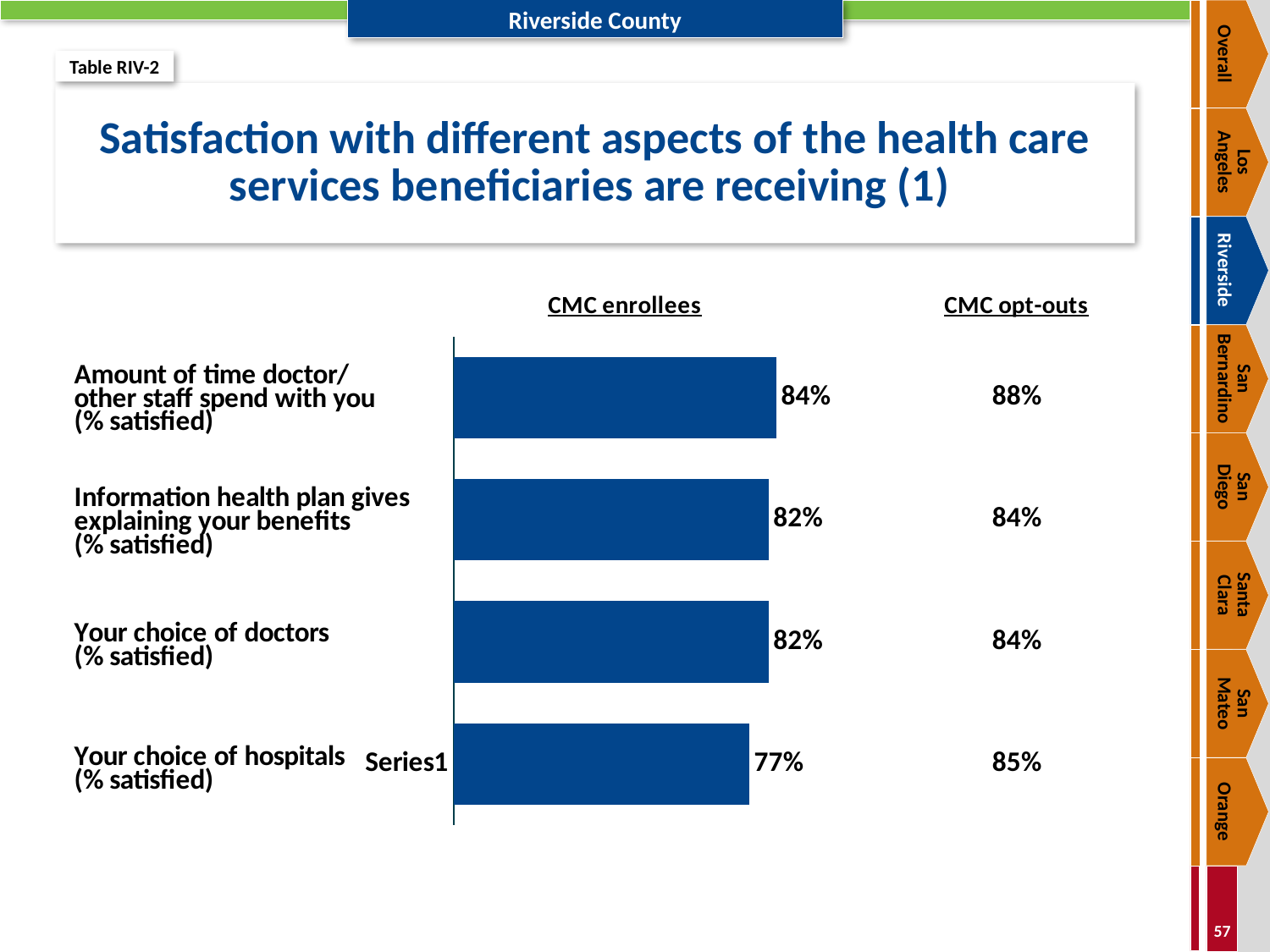
What series name is shown next to the bottom bar of the chart? Series1 What is the difference between the CMC enrollees values for 'Amount of time doctor/other staff spend with you' and 'Your choice of hospitals'? 7% What is the CMC enrollees value for 'Your choice of hospitals (% satisfied)'? 77% What kind of chart is shown on the slide? Bar chart Which category has the lowest CMC enrollees bar? Your choice of hospitals (% satisfied) How many bars are plotted in the chart? 4 What is the CMC enrollees value for 'Your choice of doctors (% satisfied)'? 82% Which category has the highest CMC enrollees bar? Amount of time doctor/other staff spend with you (% satisfied) What is the CMC enrollees value for 'Amount of time doctor/other staff spend with you (% satisfied)'? 84% What is the title of the slide containing the chart? Satisfaction with different aspects of the health care services beneficiaries are receiving (1) What is the difference between the CMC opt-outs and CMC enrollees values for 'Your choice of hospitals (% satisfied)'? 8% Which is larger for CMC enrollees: 'Information health plan gives explaining your benefits' or 'Your choice of hospitals'? Information health plan gives explaining your benefits